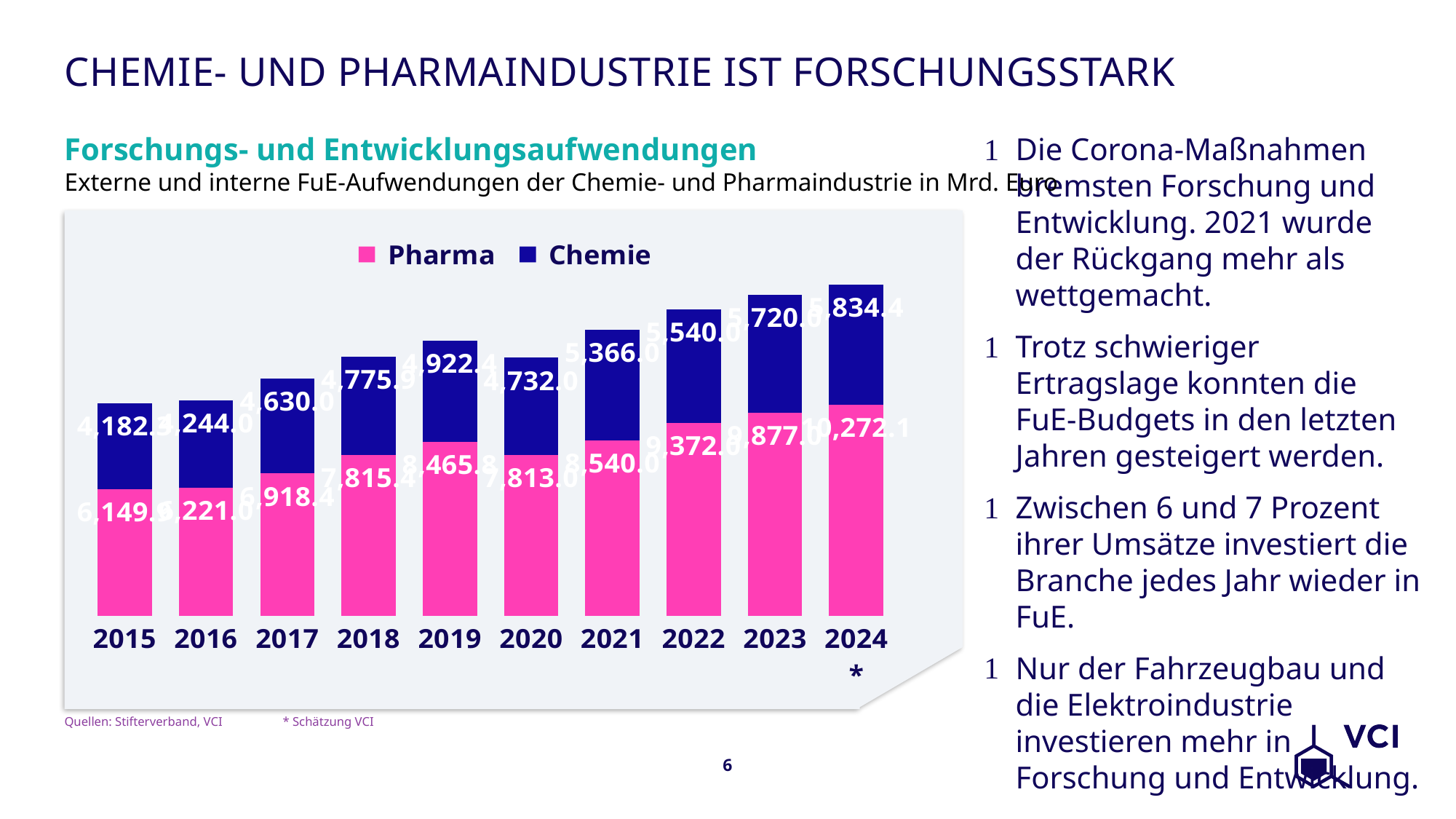
What is the Pharma value for 2024? 10,272.1 What is the Chemie value for 2021? 5,366.0 What is the Pharma value for 2020? 7,813.0 What is the total of the stacked bar for 2024? 16,106.5 In which year is the Pharma value highest? 2024 Which colour represents the Pharma series in the chart? Pink How many years are shown on the x axis of the chart? 10 Which is larger, the Pharma value for 2019 or for 2020? 2019 What is the Chemie value for 2018? 4,775.9 What kind of chart is shown on the slide? Stacked bar chart What is the difference between the Pharma values for 2024 and 2023? 395.1 How many series does the legend list? 2